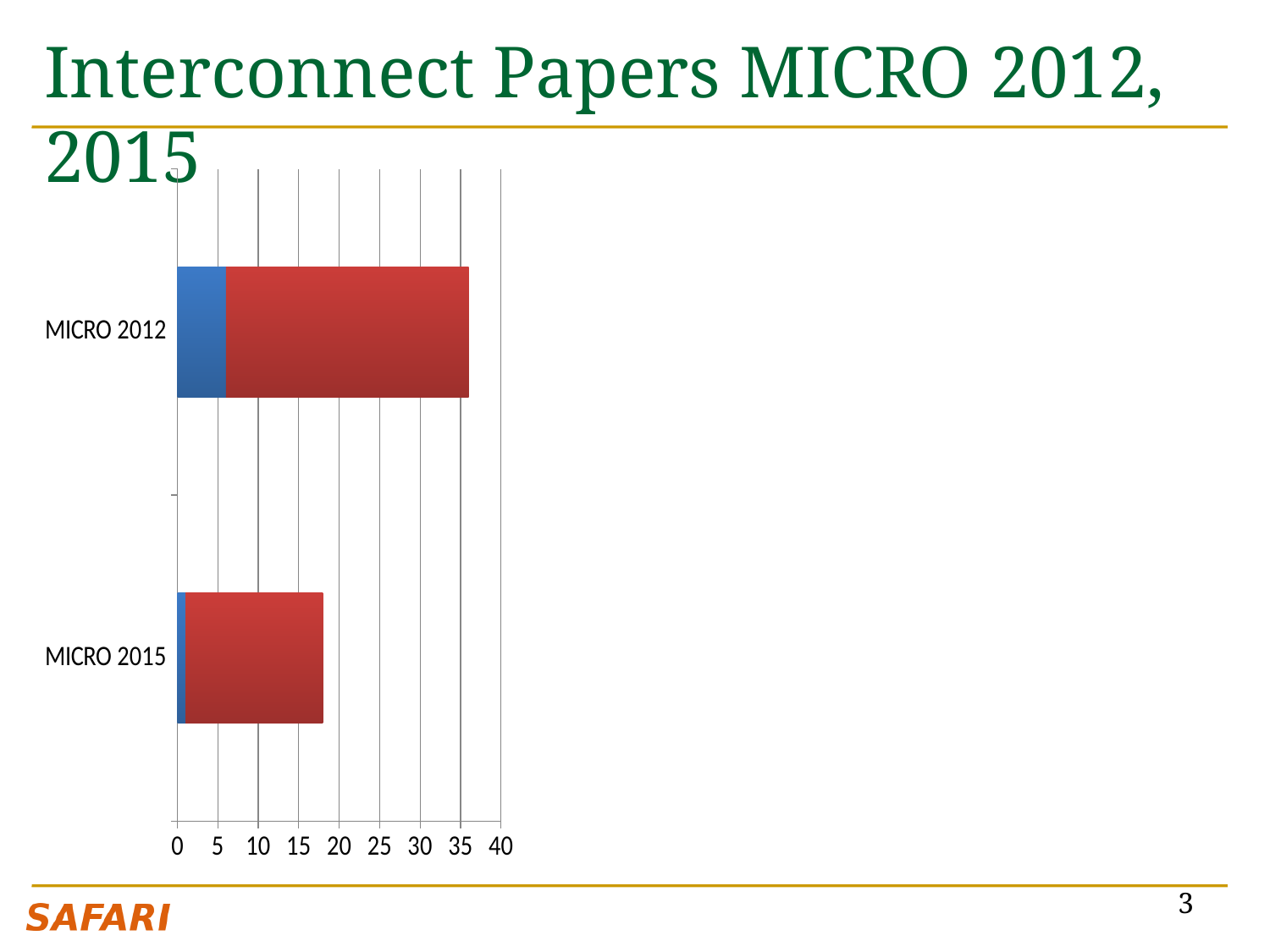
Is the total bar length for MICRO 2015 greater or less than 15? greater Which has the larger total bar, MICRO 2012 or MICRO 2015? MICRO 2012 Is the blue segment for MICRO 2012 greater or less than 10? less Does the total bar length increase or decrease from MICRO 2012 to MICRO 2015? decrease Is the total bar length for MICRO 2012 greater or less than 40? less What is the title of the slide containing the chart? Interconnect Papers MICRO 2012, 2015 How many categories are shown on the chart? 2 Which category has the longest total bar? MICRO 2012 Which category has the shortest total bar? MICRO 2015 What kind of chart is shown on the slide? bar chart